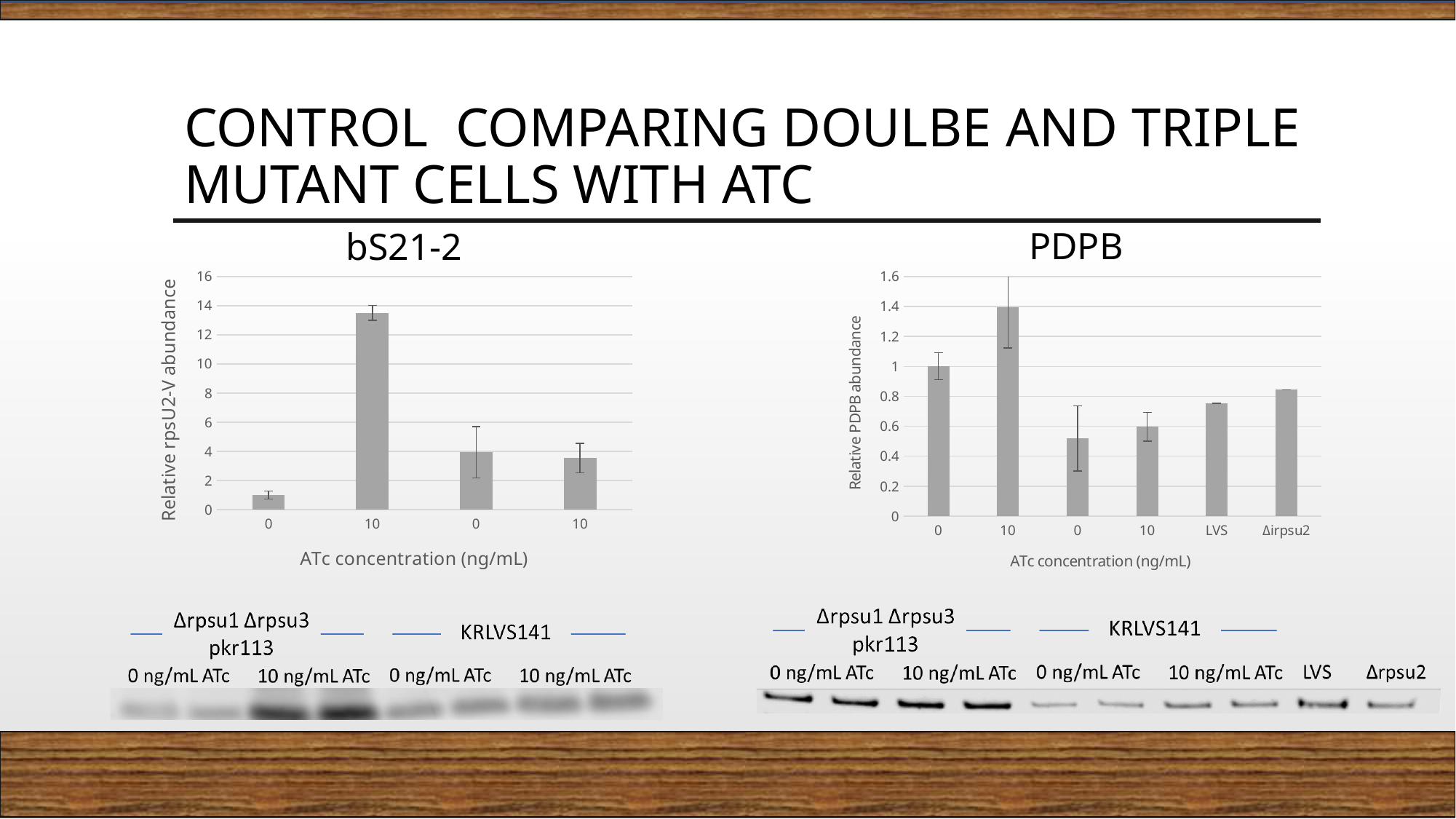
What is the y-axis title of the bS21-2 chart? Relative rpsU2-V abundance In the bS21-2 chart, which bar is the highest? the second bar (10 ng/mL ATc) What kind of chart is the bS21-2 chart? bar chart In the bS21-2 chart, is the value of the second bar (10) greater or less than 12? greater In the PDPB chart, which bar is the highest? the second bar (10 ng/mL ATc) In the PDPB chart, which bar is the lowest? the third bar (0 ng/mL ATc) How many bars are plotted in the PDPB chart? 6 How many bars are plotted in the bS21-2 chart? 4 In the PDPB chart, is the value for LVS greater or less than 0.6? greater In the PDPB chart, which is larger, the first bar (0) or the third bar (0)? the first bar In the bS21-2 chart, is the value of the first bar (0) greater or less than 2? less In the bS21-2 chart, which bar is the lowest? the first bar (0 ng/mL ATc)